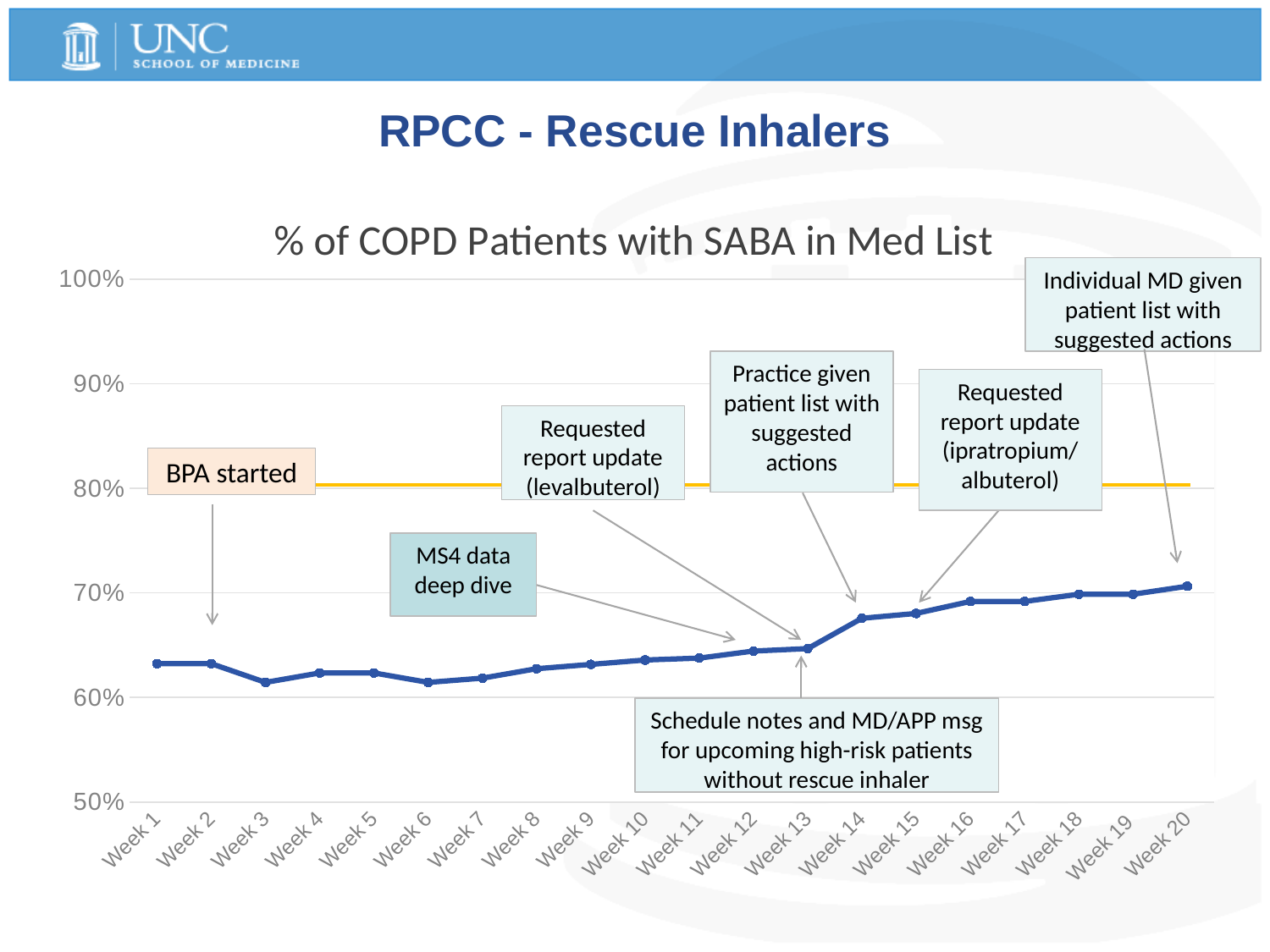
Is the value for Week 1 greater or less than 70%? less What type of chart is shown on the slide? Line chart Which is larger, the value for Week 1 or the value for Week 3? Week 1 How many weeks are plotted on the x axis of the chart? 20 Which week has the highest value in the chart? Week 20 Which is larger, the value for Week 14 or the value for Week 6? Week 14 What is the title of the chart? % of COPD Patients with SABA in Med List Is the value for Week 6 greater or less than 60%? greater Is the value for Week 14 greater or less than 70%? less Overall, do the values rise or fall from Week 1 to Week 20? Rise At what percentage level is the horizontal yellow line drawn on the chart? 80%